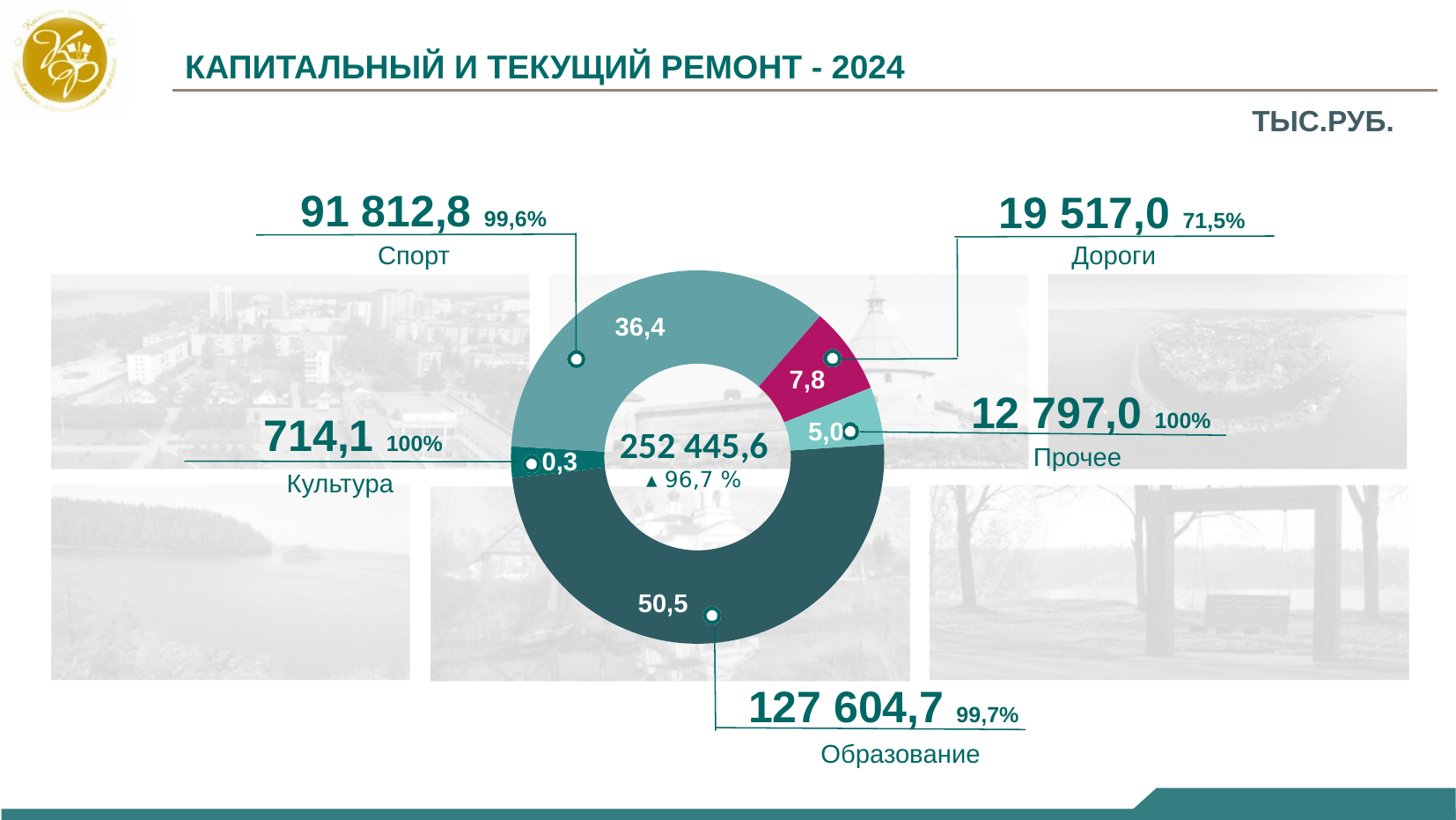
What share of the donut does Прочее take? 5,0 What total value is shown in the centre of the donut chart? 252 445,6 What kind of chart is shown on the slide? Pie (donut) chart What execution percentage is shown next to Дороги? 71,5% What is the value for Спорт in thousand rubles? 91 812,8 Which is larger, the value for Дороги or the value for Прочее? Дороги What is the value for Дороги in thousand rubles? 19 517,0 How many categories does the donut chart show? 5 Which category has the smallest value? Культура What is the value for Образование in thousand rubles? 127 604,7 What share of the donut does Образование take? 50,5 Which category has the largest value? Образование